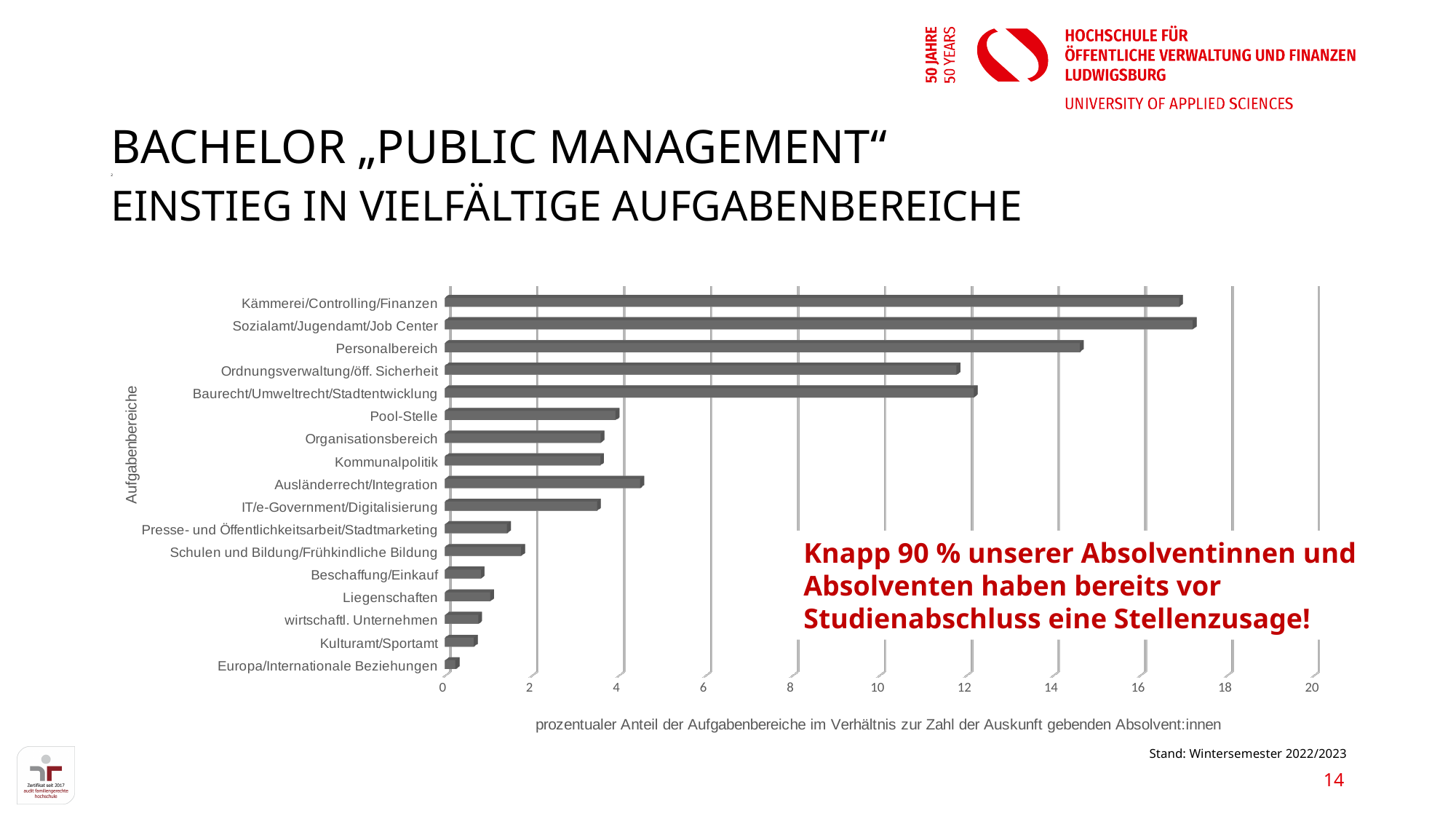
Is the value for Pool-Stelle greater or less than 6? less Is the value for Kämmerei/Controlling/Finanzen greater or less than 16? greater What is the highest tick value shown on the horizontal axis? 20 What kind of chart is shown on the slide? bar chart Is the value for Presse- und Öffentlichkeitsarbeit/Stadtmarketing greater or less than 2? less Which is larger, the value for Personalbereich or the value for Ordnungsverwaltung/öff. Sicherheit? Personalbereich Which is larger, the value for Ausländerrecht/Integration or the value for Pool-Stelle? Ausländerrecht/Integration How many task areas (categories) are plotted in the chart? 17 Which task area has the highest value in the chart? Sozialamt/Jugendamt/Job Center What is the label of the vertical axis of the chart? Aufgabenbereiche Which task area has the lowest value in the chart? Europa/Internationale Beziehungen